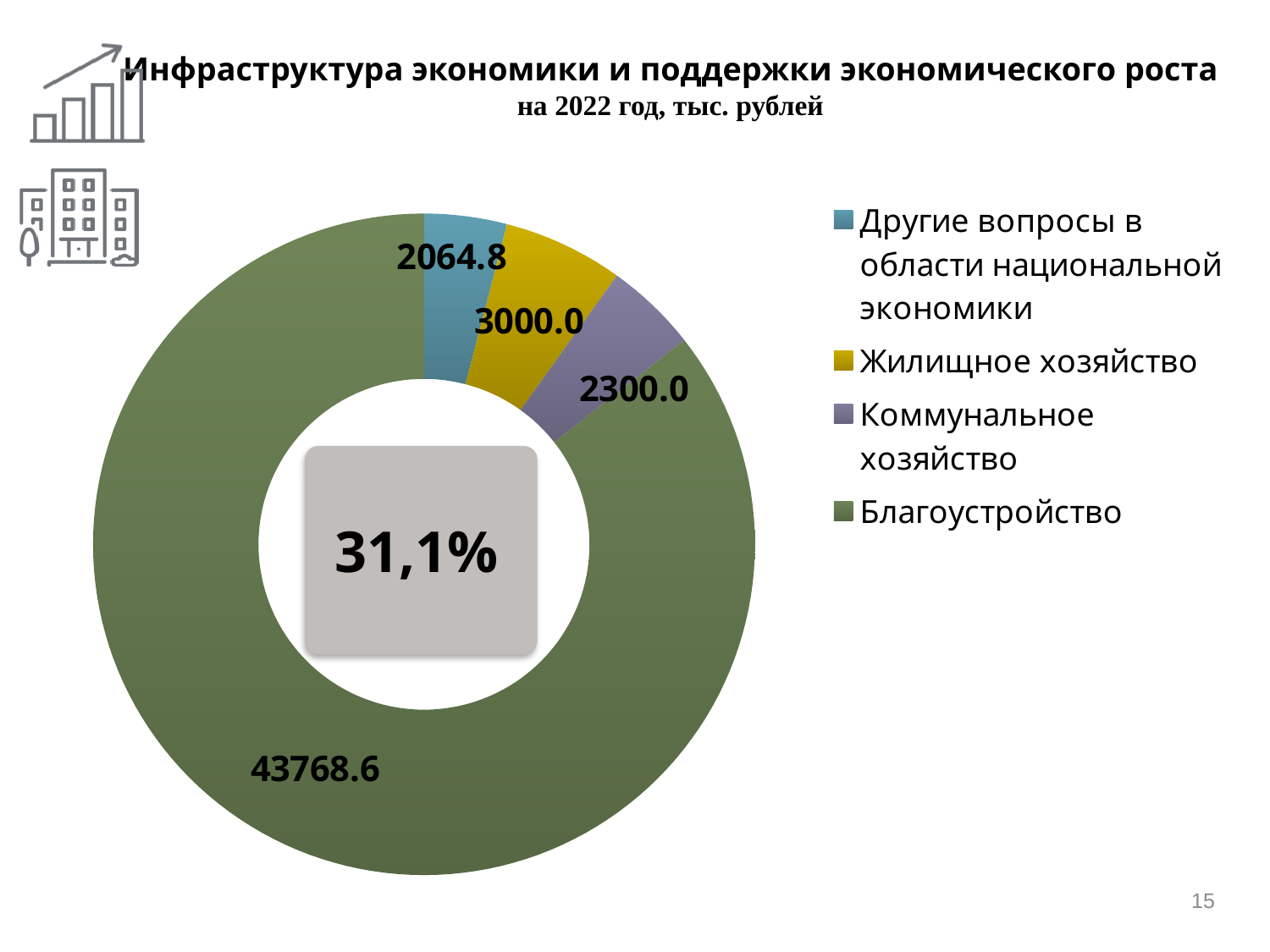
What percentage is shown in the centre of the chart? 31,1% What is the value for Другие вопросы в области национальной экономики? 2064.8 What kind of chart is shown on the slide? Doughnut (pie) chart What unit is stated in the chart subtitle? тыс. рублей Which is larger, Коммунальное хозяйство or Жилищное хозяйство? Жилищное хозяйство What is the value for Жилищное хозяйство? 3000.0 How many categories does the chart show? 4 What is the value for Благоустройство? 43768.6 Which category has the smallest value? Другие вопросы в области национальной экономики What is the difference between Жилищное хозяйство and Коммунальное хозяйство? 700.0 Which category has the largest value? Благоустройство What is the value for Коммунальное хозяйство? 2300.0